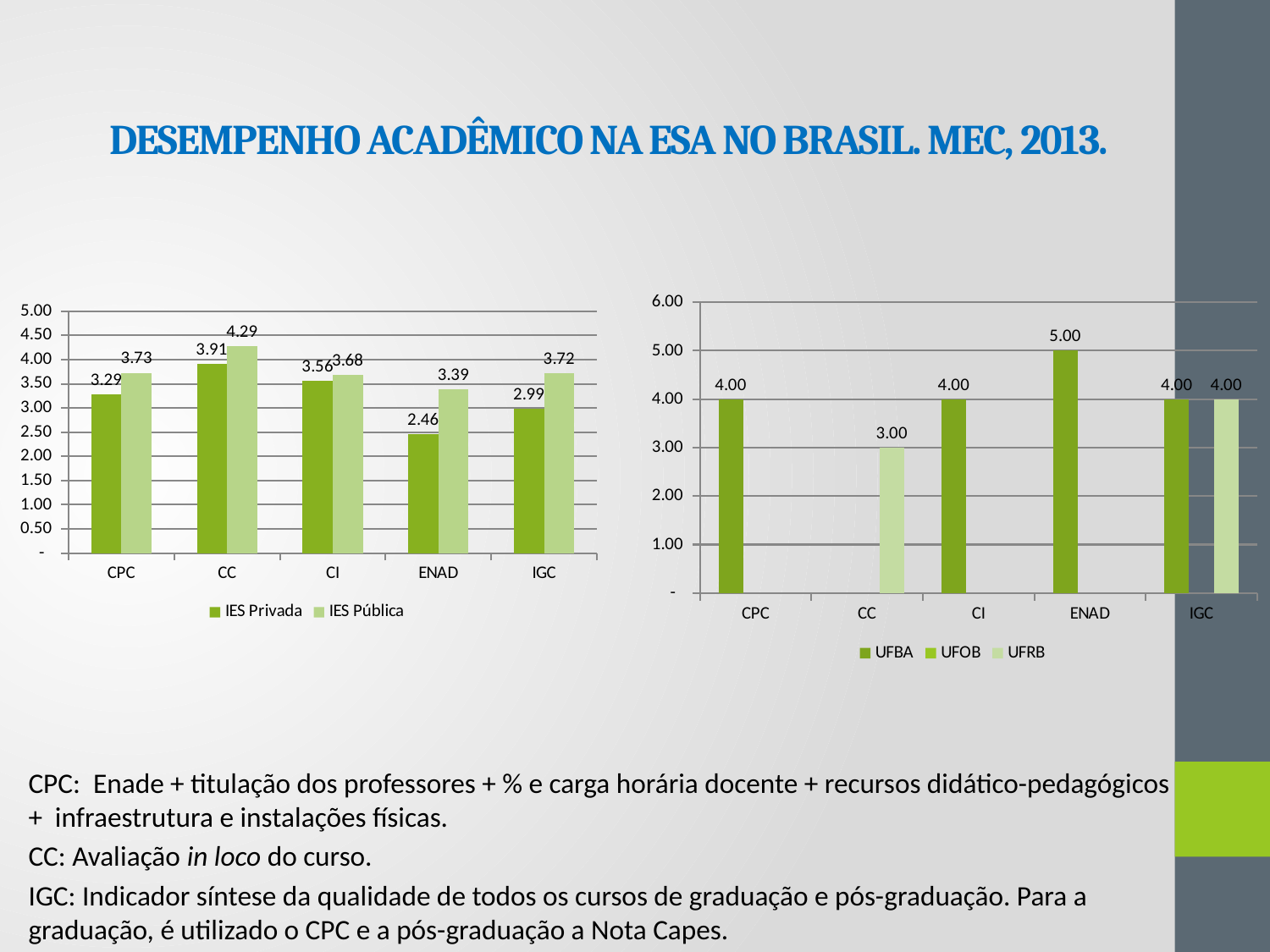
On the left chart, which category has the highest IES Pública value? CC On the right chart, what is the UFBA value for ENAD? 5.00 On the left chart, which is larger for IGC: IES Privada or IES Pública? IES Pública On the right chart, what is the UFRB value for CC? 3.00 On the left chart, what is the IES Pública value for CC? 4.29 On the left chart, what is the IES Privada value for ENAD? 2.46 How many series does the legend of the left chart list? 2 What kind of chart is the left chart? Bar chart How many categories are shown on the x axis of the left chart? 5 On the left chart, what is the difference between the IES Pública and IES Privada values for ENAD? 0.93 On the left chart, which category has the lowest IES Privada value? ENAD How many series does the legend of the right chart list? 3